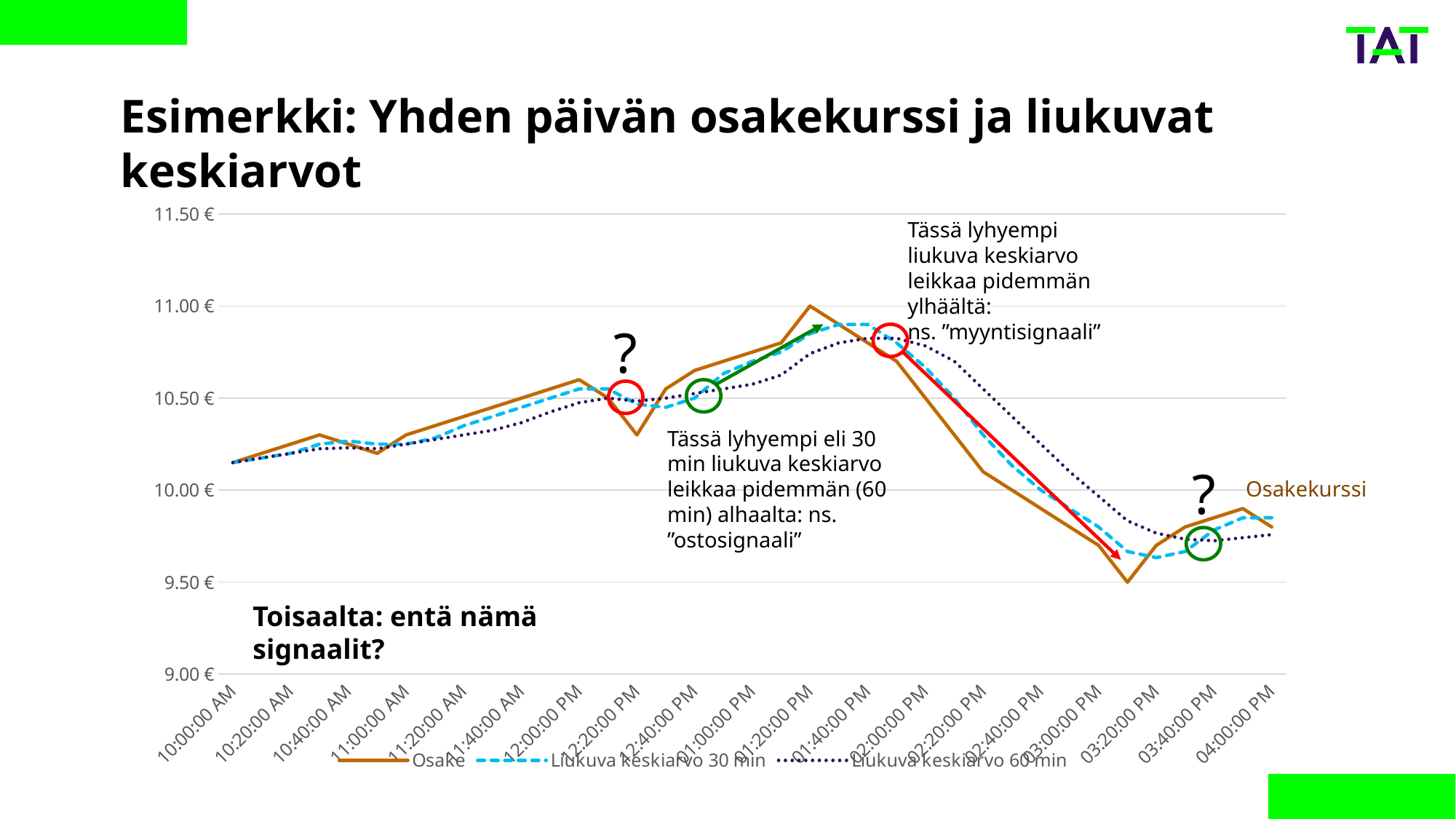
What is the value of the Osake series at 01:20:00 PM? 11.00 € Is the Osake value at 10:00:00 AM greater or less than 10.50 €? less Is the Osake value at 03:00:00 PM greater or less than 10.00 €? less Which series is drawn as a solid orange line in the chart? Osake How many time points are labelled along the x axis of the chart? 19 What kind of chart is shown on the slide? Line chart Is the Osake value at 12:00:00 PM greater or less than 10.50 €? greater How many series does the chart legend list? 3 Does the Osake series rise or fall between 01:20:00 PM and 03:20:00 PM? Fall At which time does the Osake series reach its highest value? 01:20:00 PM